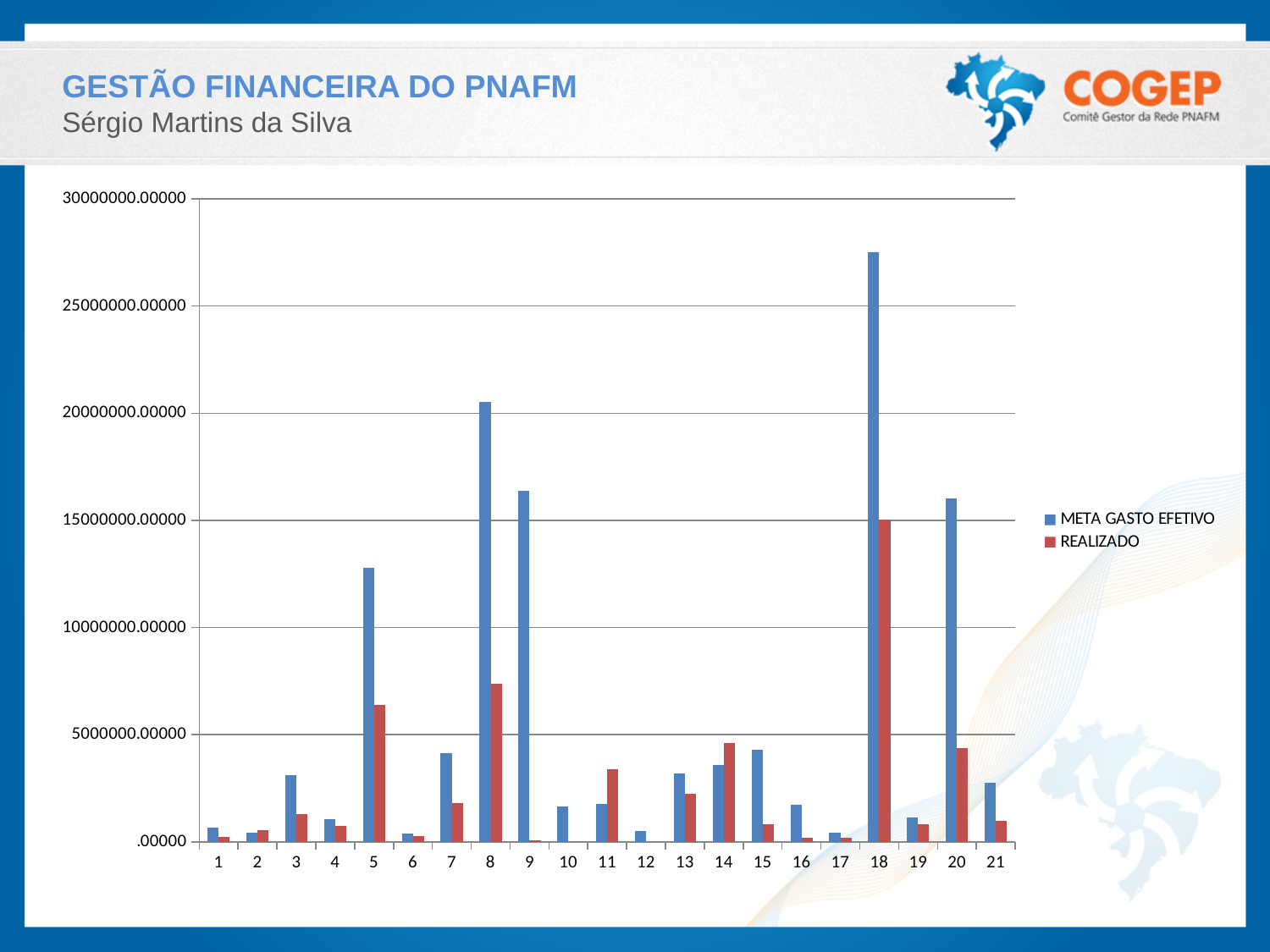
What kind of chart is shown on the slide? bar chart For category 14, which series has the larger value, META GASTO EFETIVO or REALIZADO? REALIZADO Is the META GASTO EFETIVO value for category 5 greater or less than 10000000.00000? greater Is the REALIZADO value for category 8 greater or less than 5000000.00000? greater Is the META GASTO EFETIVO value for category 15 greater or less than 5000000.00000? less How many categories are shown along the x axis? 21 How many series does the legend list? 2 Which category has the highest META GASTO EFETIVO value? 18 Which series is shown in blue in the legend? META GASTO EFETIVO Which category has the highest REALIZADO value? 18